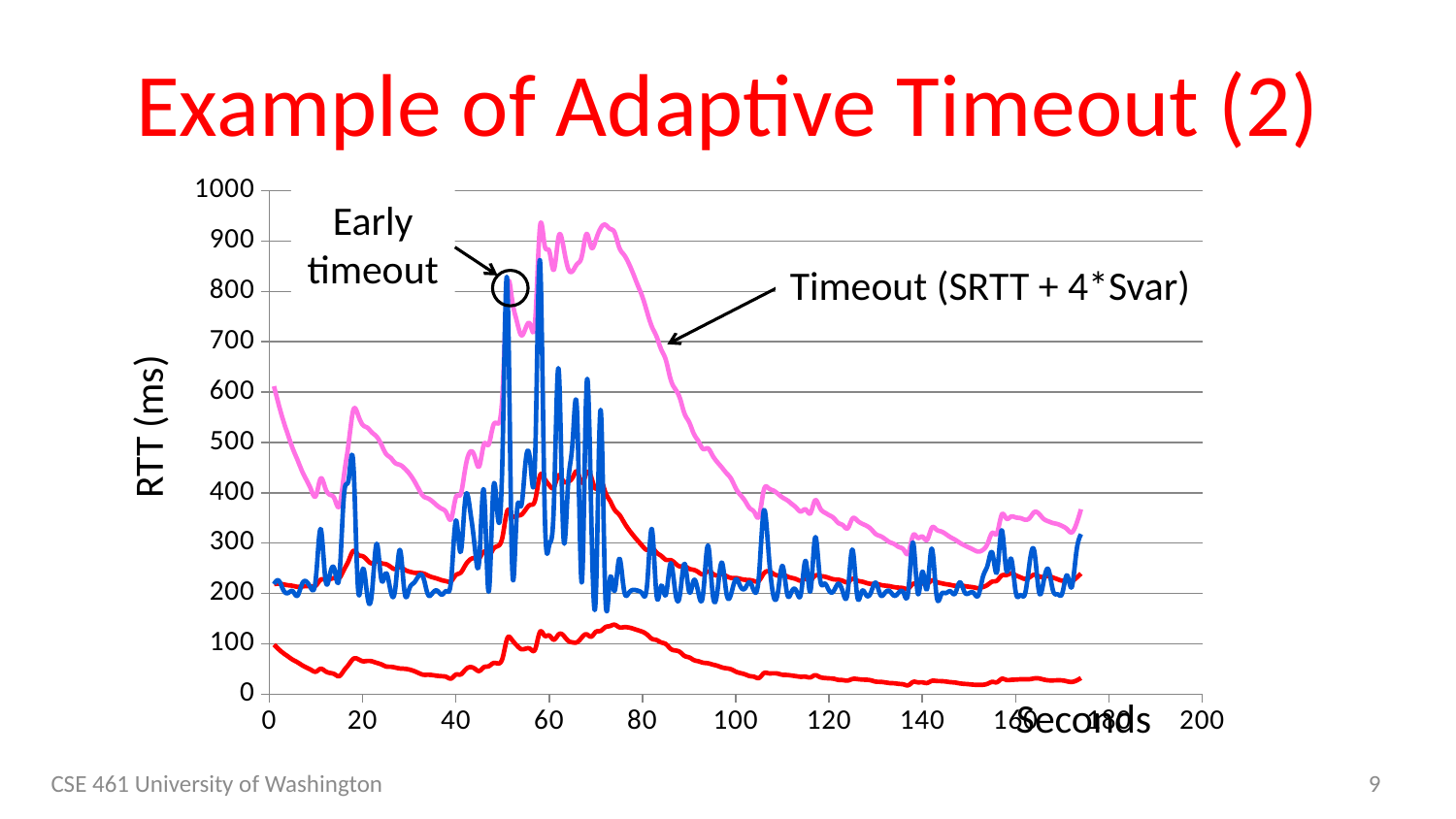
Is the value of the Timeout (SRTT + 4*Svar) line at 0 seconds greater or less than 500? greater How many lines are plotted on the chart? 4 Does the Timeout (SRTT + 4*Svar) line rise or fall between 40 and 60 seconds? rise Is the peak value of the Timeout (SRTT + 4*Svar) line greater or less than 900? greater What kind of chart is shown on the slide? line chart What is the label on the vertical axis of the chart? RTT (ms) Is the value of the Timeout (SRTT + 4*Svar) line at 100 seconds greater or less than 500? less Does the Timeout (SRTT + 4*Svar) line rise or fall between 80 and 140 seconds? fall What is the label on the horizontal axis of the chart? Seconds